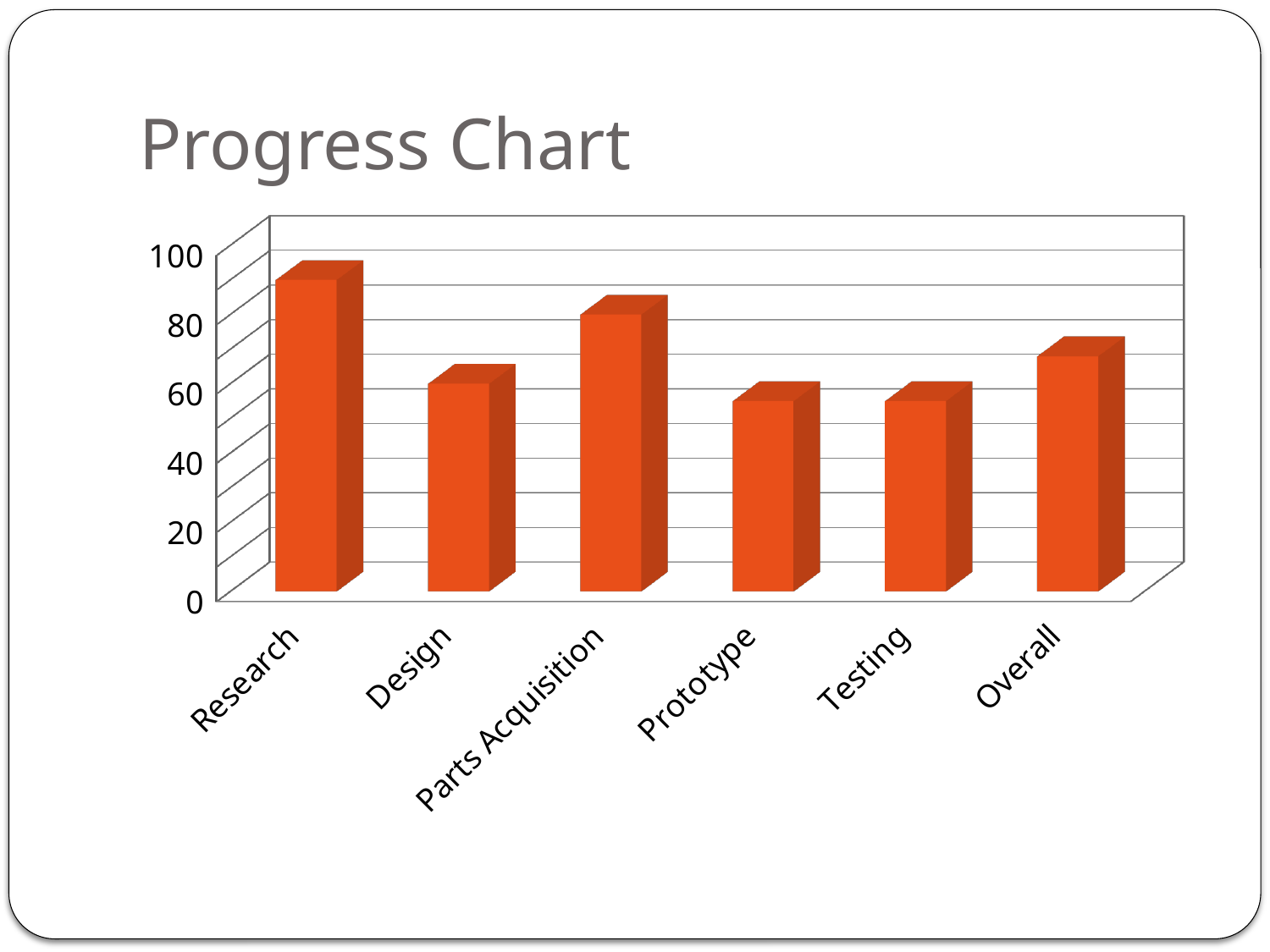
How many categories are shown on the x axis of the chart? 6 What colour are the bars in the chart? orange Is the value for Design greater or less than 80? less Is the value for Prototype greater or less than 80? less Is the value for Parts Acquisition greater or less than 60? greater What kind of chart is shown on the slide? bar chart Which category has the highest bar in the chart? Research What is the title of the chart? Progress Chart Which is larger, the value for Research or the value for Design? Research Which is larger, the value for Parts Acquisition or the value for Overall? Parts Acquisition